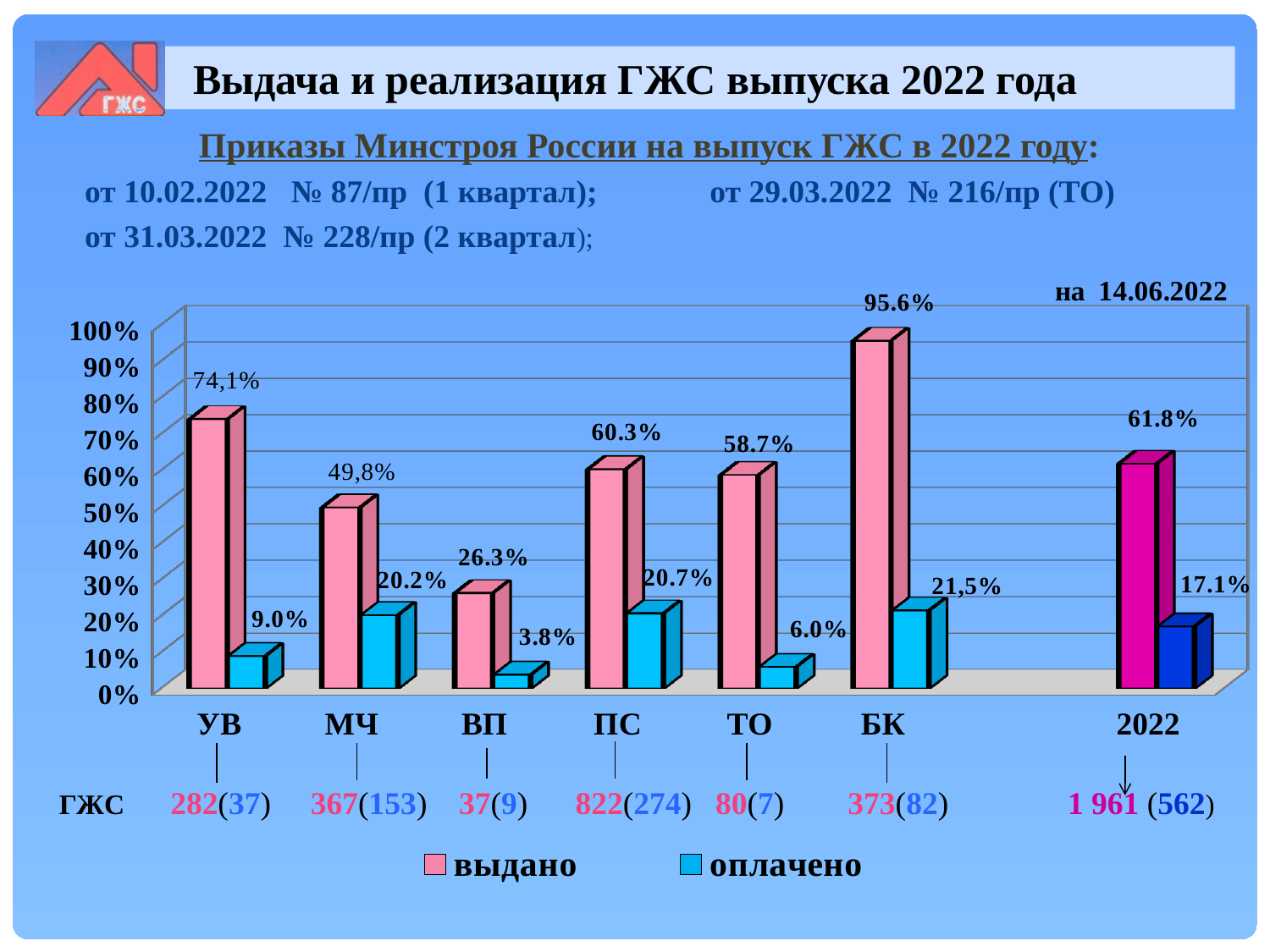
What is the difference between the 'выдано' and 'оплачено' values for ТО? 52.7% What kind of chart is shown on the slide? bar chart What is the value of the 'выдано' bar for БК? 95.6% Which category has the highest 'выдано' value? БК What is the value of the 'выдано' bar for УВ? 74,1% What is the value of the 'оплачено' bar for ПС? 20.7% Which is larger: the 'оплачено' value for МЧ or for БК? БК What are the two legend entries of the chart? выдано, оплачено Which category has the lowest 'оплачено' value? ВП How many categories are shown on the x axis? 7 How many series does the legend list? 2 What is the value of the 'оплачено' bar for ВП? 3.8%